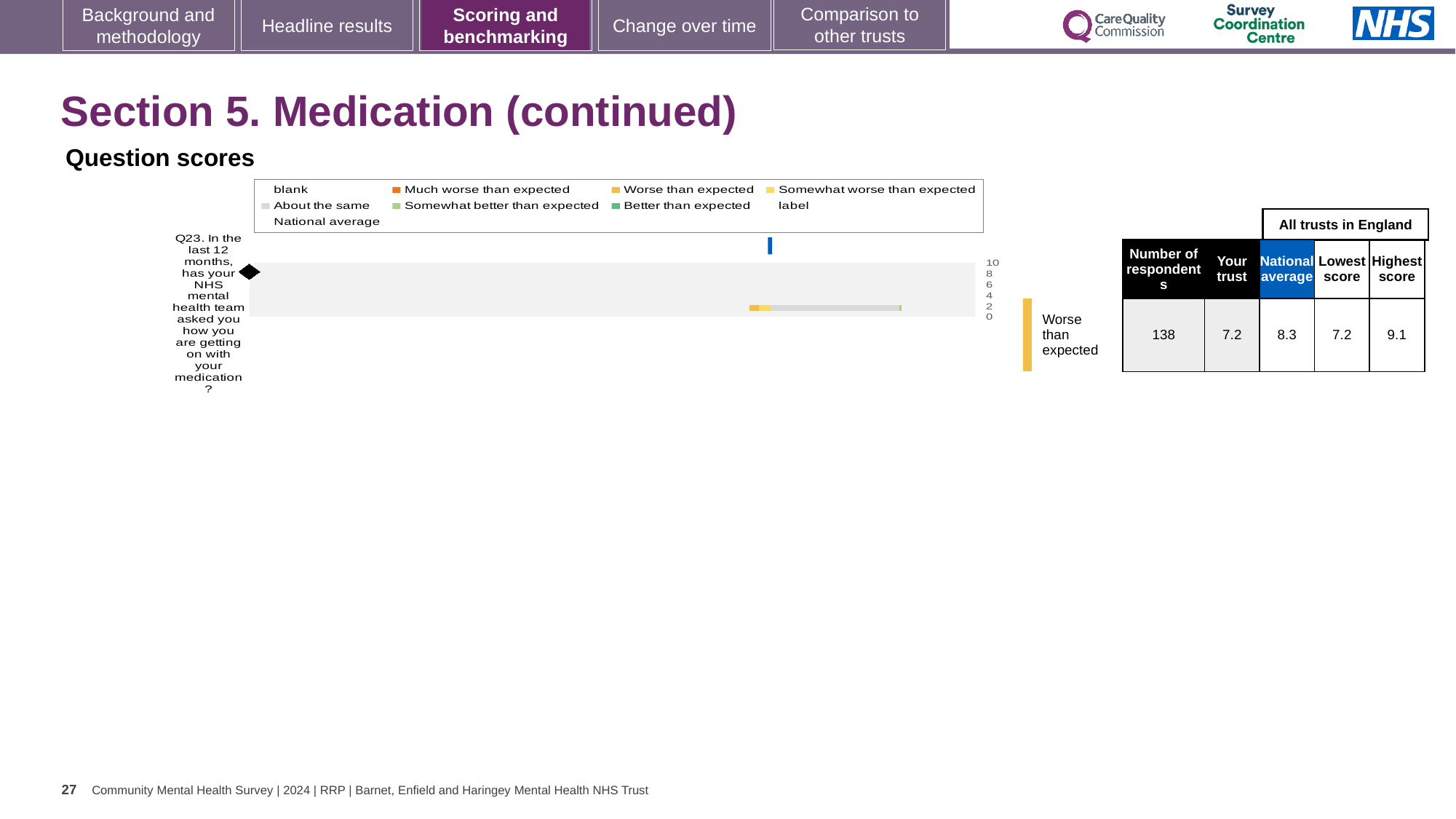
How many respondents answered Q23? 138 What is the national average score for Q23? 8.3 What is the difference between the national average and the 'Your trust' score for Q23? 1.1 What is the highest score among all trusts in England for Q23? 9.1 Which is larger for Q23, the 'Your trust' score or the national average? National average What is the 'Your trust' score for Q23 (In the last 12 months, has your NHS mental health team asked you how you are getting on with your medication?)? 7.2 Is the 'Your trust' score for Q23 greater or less than 8? less What benchmark category label is shown next to the Q23 bar? Worse than expected What kind of chart is used for the Question scores? Bar chart What is the difference between the highest and lowest scores among all trusts in England for Q23? 1.9 What is the lowest score among all trusts in England for Q23? 7.2 How many questions are plotted on the Question scores chart? 1